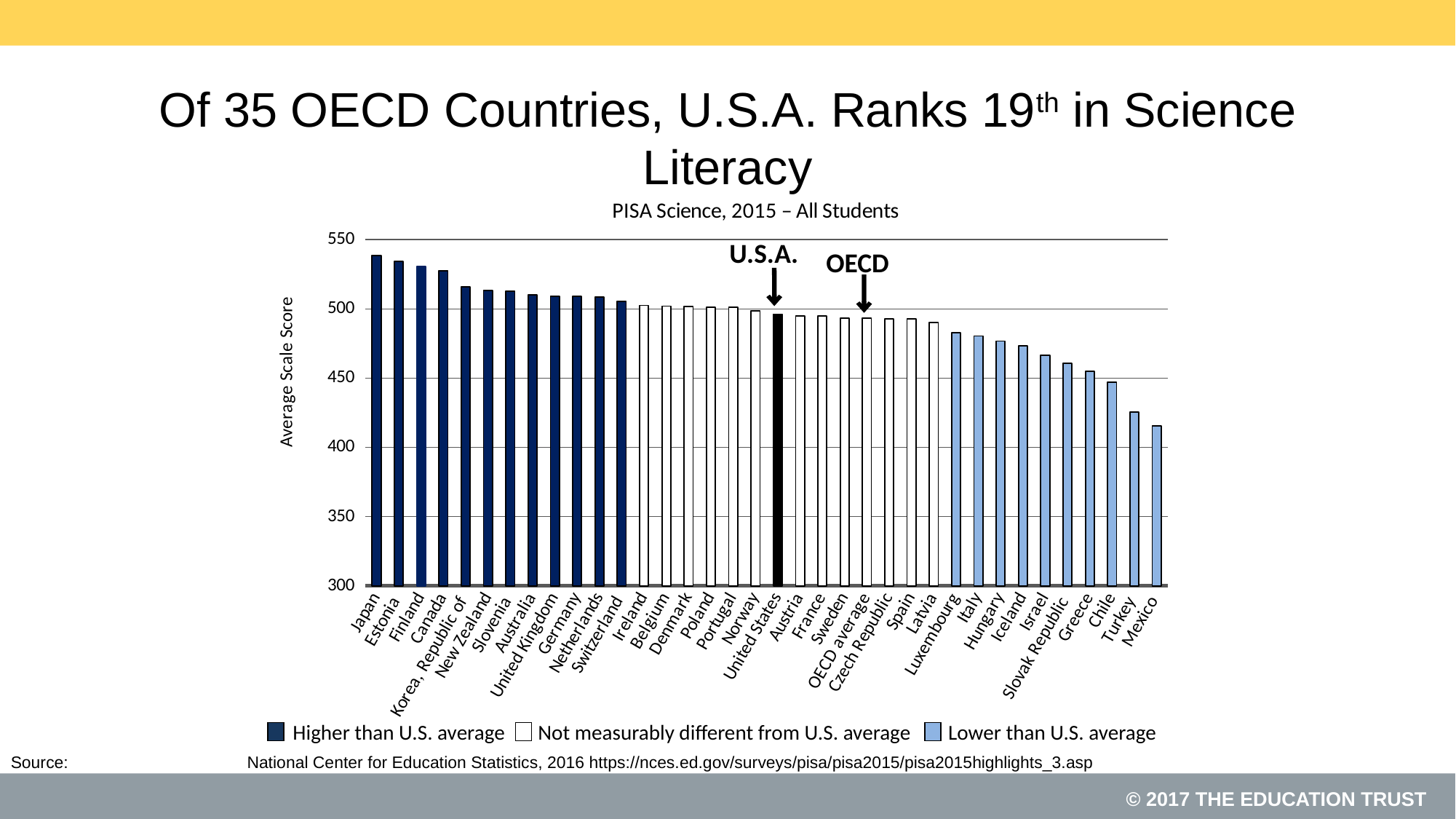
Which country has the lowest average scale score in the chart? Mexico Is the value for Japan greater or less than 500? greater Do the values rise or fall moving from left to right along the x axis? Fall How many bars are plotted in the chart? 36 Which country has the highest average scale score in the chart? Japan What kind of chart is shown on the slide? Bar chart Which has a higher average scale score, Finland or Greece? Finland What is the label on the vertical axis of the chart? Average Scale Score Is the value for Mexico greater or less than 450? less Is the value for Turkey greater or less than 450? less How many entries does the legend list? 3